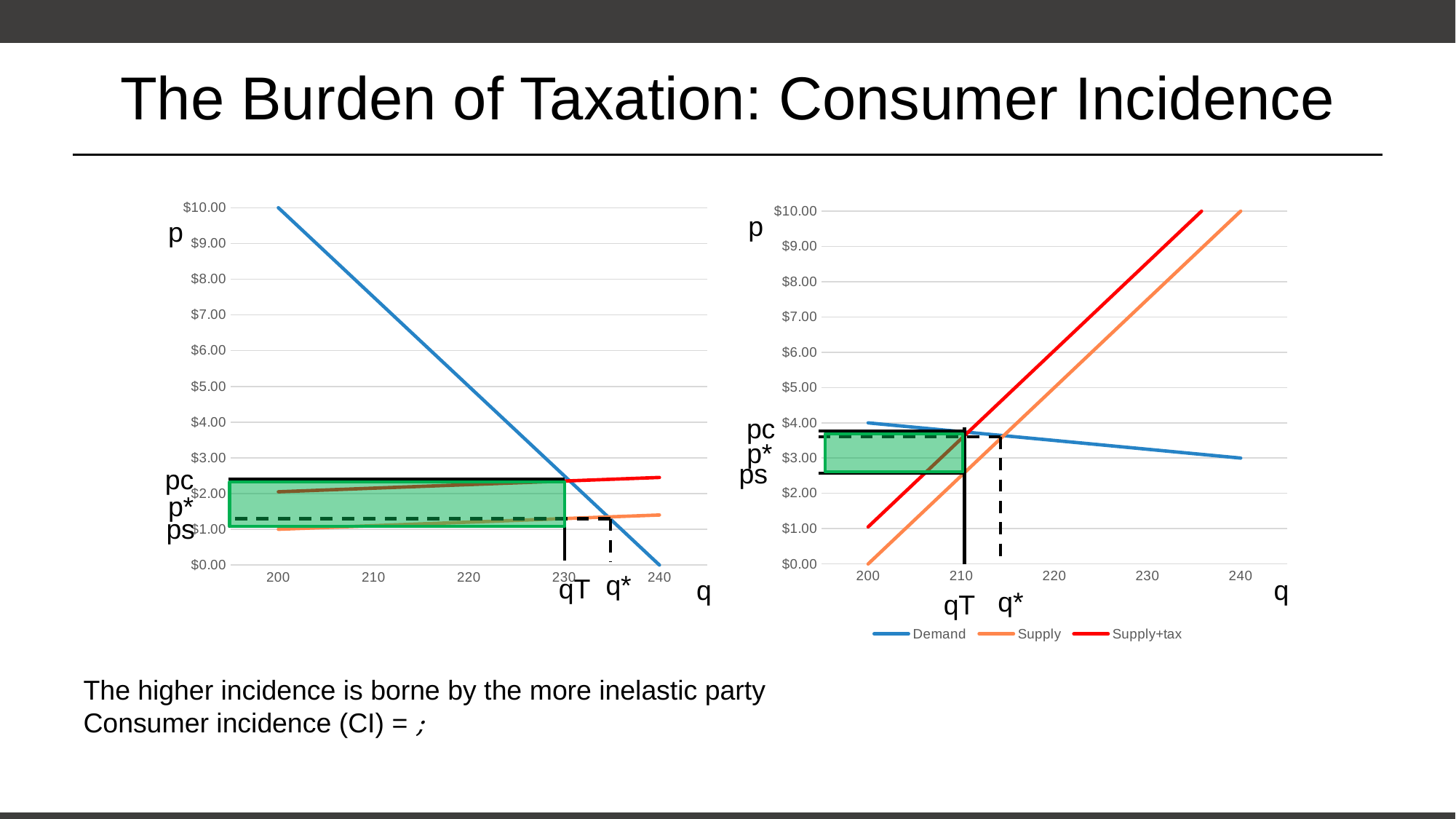
In the left chart, does the demand line rise or fall as q increases? fall How many series does the legend of the right chart list? 3 In the right chart, what is the price on the Supply line at q = 200? $0.00 In the right chart, is the value of pc greater or less than $3.00? greater What are the legend entries of the right chart? Demand, Supply, Supply+tax In the right chart, at what quantity on the x axis is qT marked? 210 In the right chart, what is the price on the Supply line at q = 240? $10.00 In the left chart, what is the price on the demand line at q = 200? $10.00 In the left chart, what is the price on the demand line at q = 240? $0.00 What kind of chart is the left chart on the slide? line chart In the right chart, what is the price on the Demand line at q = 240? $3.00